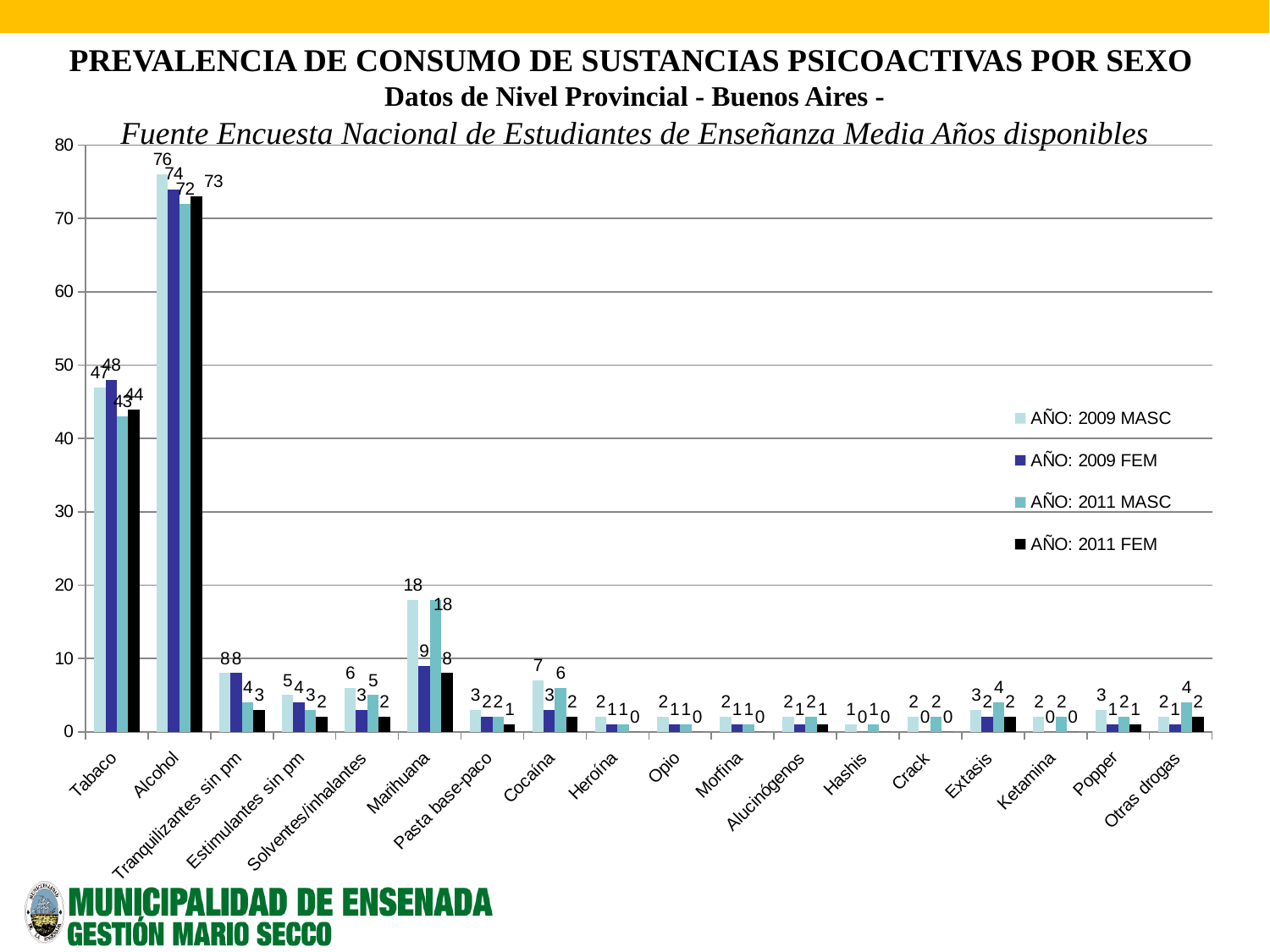
What is the value for Marihuana in the AÑO: 2011 MASC series? 18 How many series does the legend list? 4 Which category has the highest value in the AÑO: 2009 FEM series? Alcohol What is the value for Tabaco in the AÑO: 2011 FEM series? 44 What is the difference between the AÑO: 2009 MASC and AÑO: 2011 MASC values for Tabaco? 4 Which series is shown in black in the legend? AÑO: 2011 FEM What kind of chart is shown on the slide? Bar chart How many substance categories are shown on the x axis? 18 What is the value for Cocaína in the AÑO: 2009 MASC series? 7 What is the difference between the AÑO: 2009 MASC and AÑO: 2009 FEM values for Marihuana? 9 What is the value for Alcohol in the AÑO: 2009 MASC series? 76 Which is larger for Tranquilizantes sin pm: the AÑO: 2009 MASC value or the AÑO: 2011 FEM value? AÑO: 2009 MASC